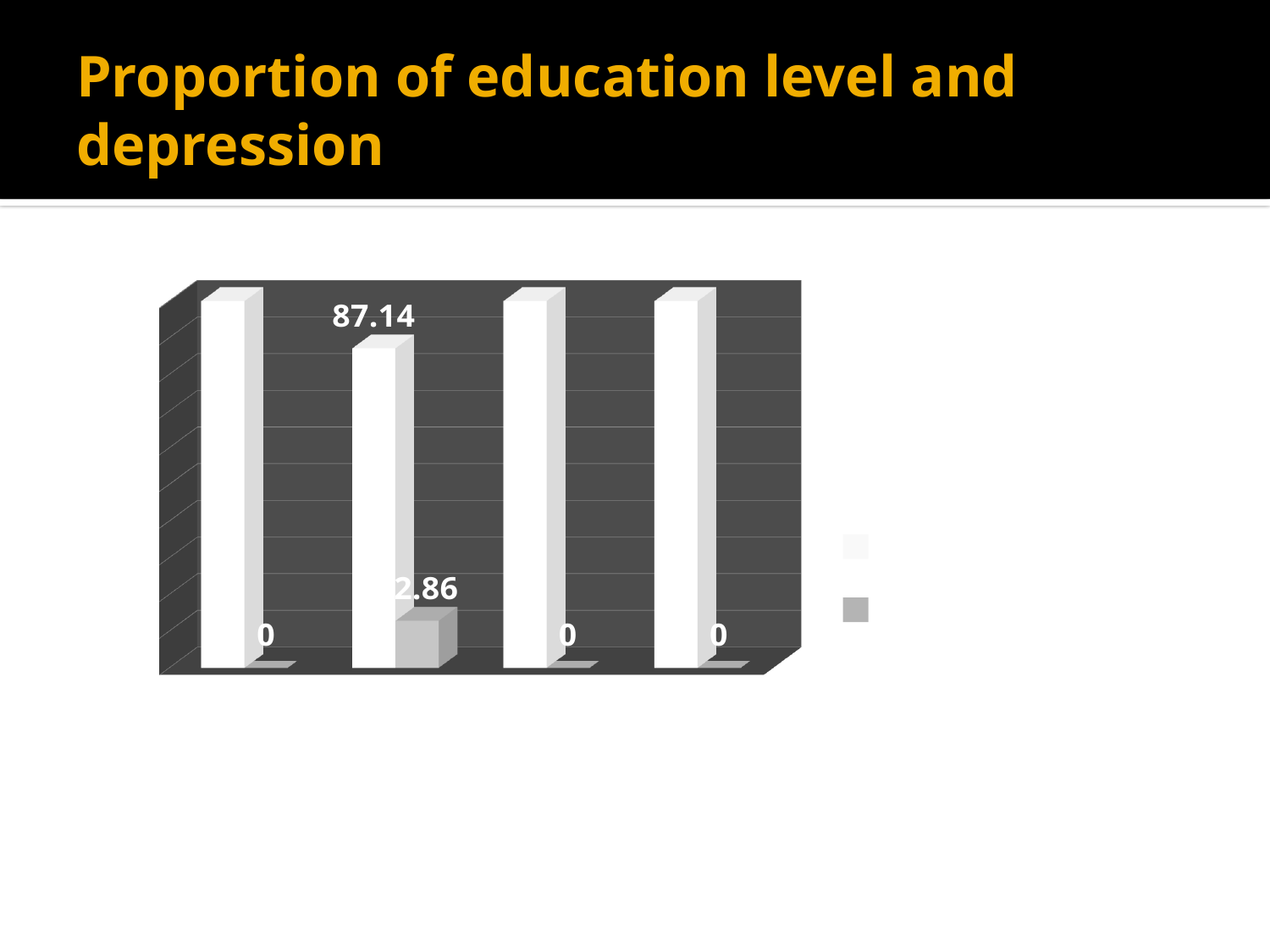
What is the difference between the white bar and the grey bar in the second group from the left? 74.28 What is the value labelled on the tall white bar in the second group from the left? 87.14 What is the value labelled on the short grey bar in the second group from the left? 12.86 In the second group from the left, which is larger: the white bar or the grey bar? the white bar What value is labelled on the grey bar in the fourth group from the left? 0 How many series does the legend list? 2 How many groups of bars are plotted in the chart? 4 What is the title of the chart slide? Proportion of education level and depression What value is labelled on the grey bar in the first group from the left? 0 Which group has the highest grey-series value? the second group from the left What kind of chart is shown on the slide? bar chart Which group has the lowest white-series value? the second group from the left